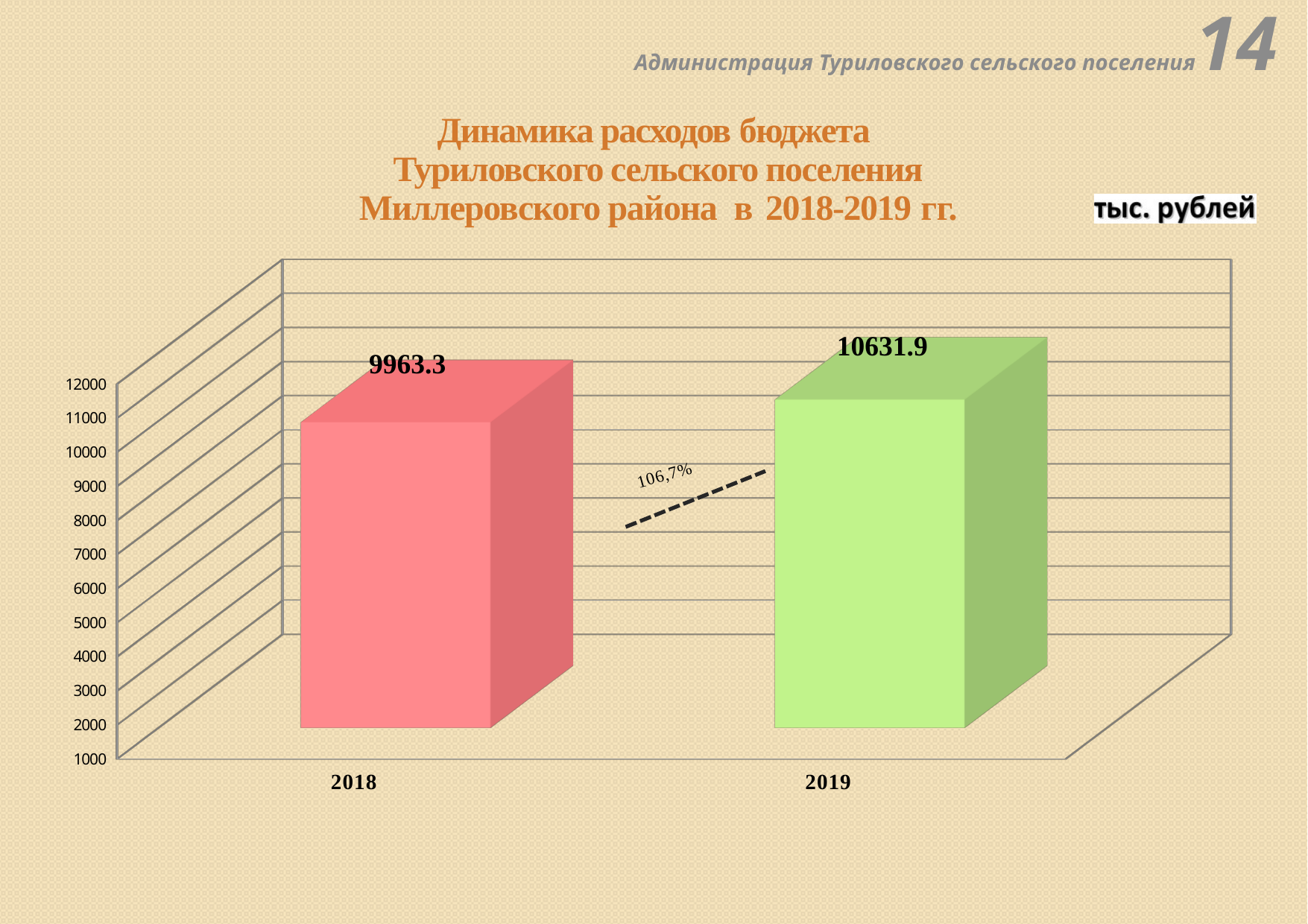
Is the value for 2019 greater or less than 10000? greater What is the difference between the 2019 and 2018 expenditure values? 668.6 What is the budget expenditure value shown for 2018? 9963.3 What is the budget expenditure value shown for 2019? 10631.9 How many years (categories) are plotted on the chart? 2 Which year has the lower budget expenditure? 2018 Which year has the higher budget expenditure? 2019 Is the value for 2018 larger or smaller than the value for 2019? smaller What percentage is written on the dashed line between the two bars? 106,7% Do the values rise or fall from 2018 to 2019? rise Is the value for 2018 greater or less than 10000? less What kind of chart is shown on the slide? bar chart